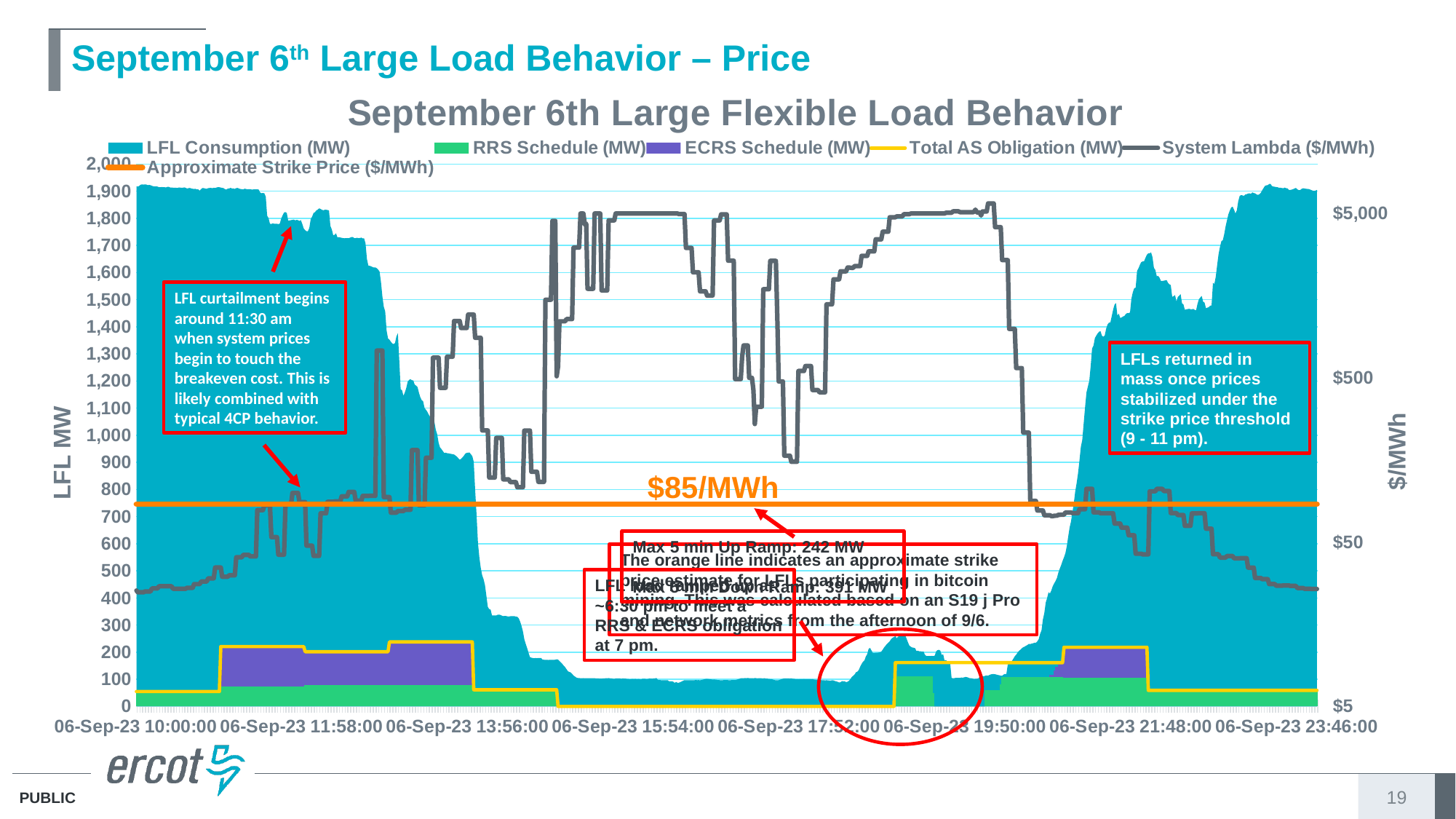
What is the title of the chart? September 6th Large Flexible Load Behavior What is the label of the right-hand vertical axis? $/MWh What kind of chart is shown on the slide? area and line chart How many series does the chart legend list? 6 Is the System Lambda value at 06-Sep-23 10:00:00 greater or less than $50? less Does LFL Consumption rise or fall between 06-Sep-23 10:00:00 and 06-Sep-23 15:54:00? fall Is the LFL Consumption value at 06-Sep-23 17:52:00 greater or less than 500? less Is the LFL Consumption value at 06-Sep-23 10:00:00 greater or less than 1,800? greater Does LFL Consumption rise or fall between 06-Sep-23 19:50:00 and 06-Sep-23 23:46:00? rise What is the Max 5 min Up Ramp value stated in the annotation on the chart? 242 MW Which is larger, LFL Consumption at 06-Sep-23 10:00:00 or at 06-Sep-23 17:52:00? 06-Sep-23 10:00:00 What value is labeled on the Approximate Strike Price line? $85/MWh